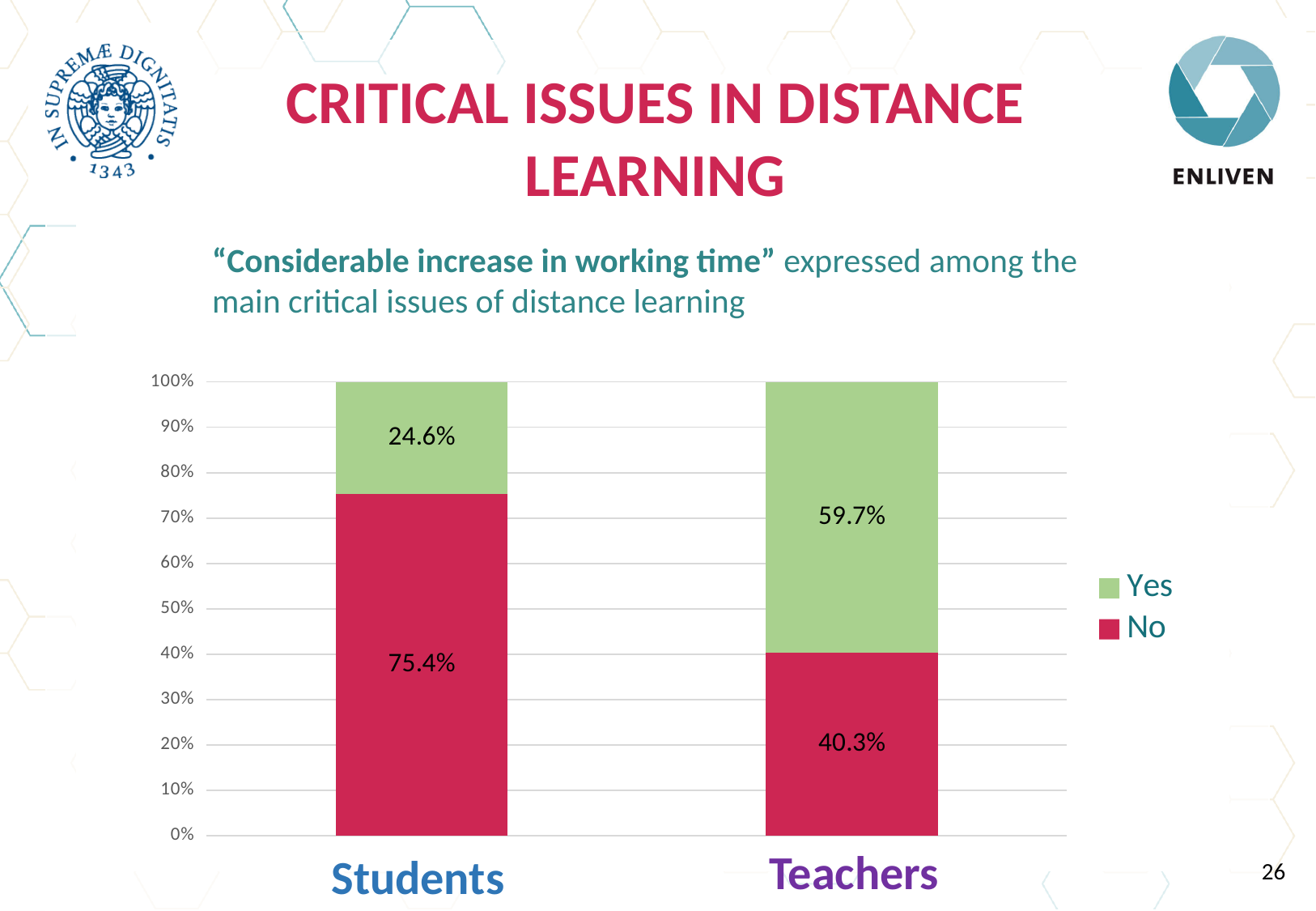
How many groups are shown on the x axis? 2 Which group has the higher Yes percentage, Students or Teachers? Teachers How many series does the legend list? 2 What percentage of Teachers answered Yes? 59.7% What percentage of Students answered No? 75.4% What percentage of Teachers answered No? 40.3% What is the difference between the No and Yes percentages for Students? 50.8% What percentage of Students answered Yes? 24.6% What is the difference between the Yes percentages for Teachers and Students? 35.1% Which colour represents the Yes series in the legend? Green Which group has the higher No percentage? Students What kind of chart is shown on the slide? Stacked bar chart